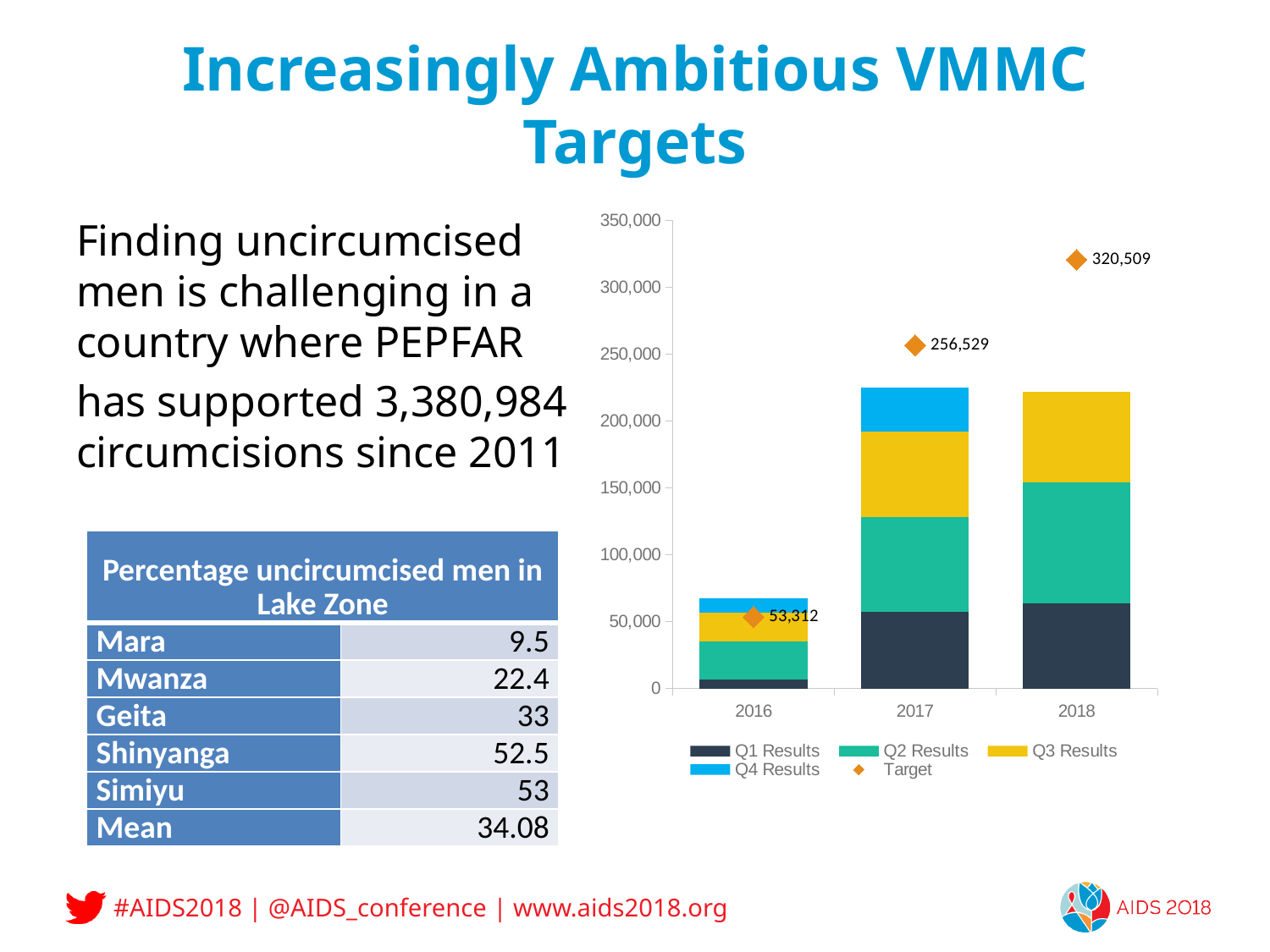
Which year has the lowest Target value? 2016 Is the Target value for 2017 larger than the Target value for 2016? Yes Which year has the highest Target value? 2018 Is the total stacked bar for 2017 greater or less than 200,000? greater How many series does the chart legend list? 5 What is the Target value for 2016? 53,312 What is the Target value for 2018? 320,509 Is the total stacked bar for 2016 greater or less than 100,000? less What is the Target value for 2017? 256,529 What is the difference between the Target values for 2018 and 2017? 63,980 How many years are shown on the x axis of the chart? 3 Do the Target values rise or fall from 2016 to 2018? rise